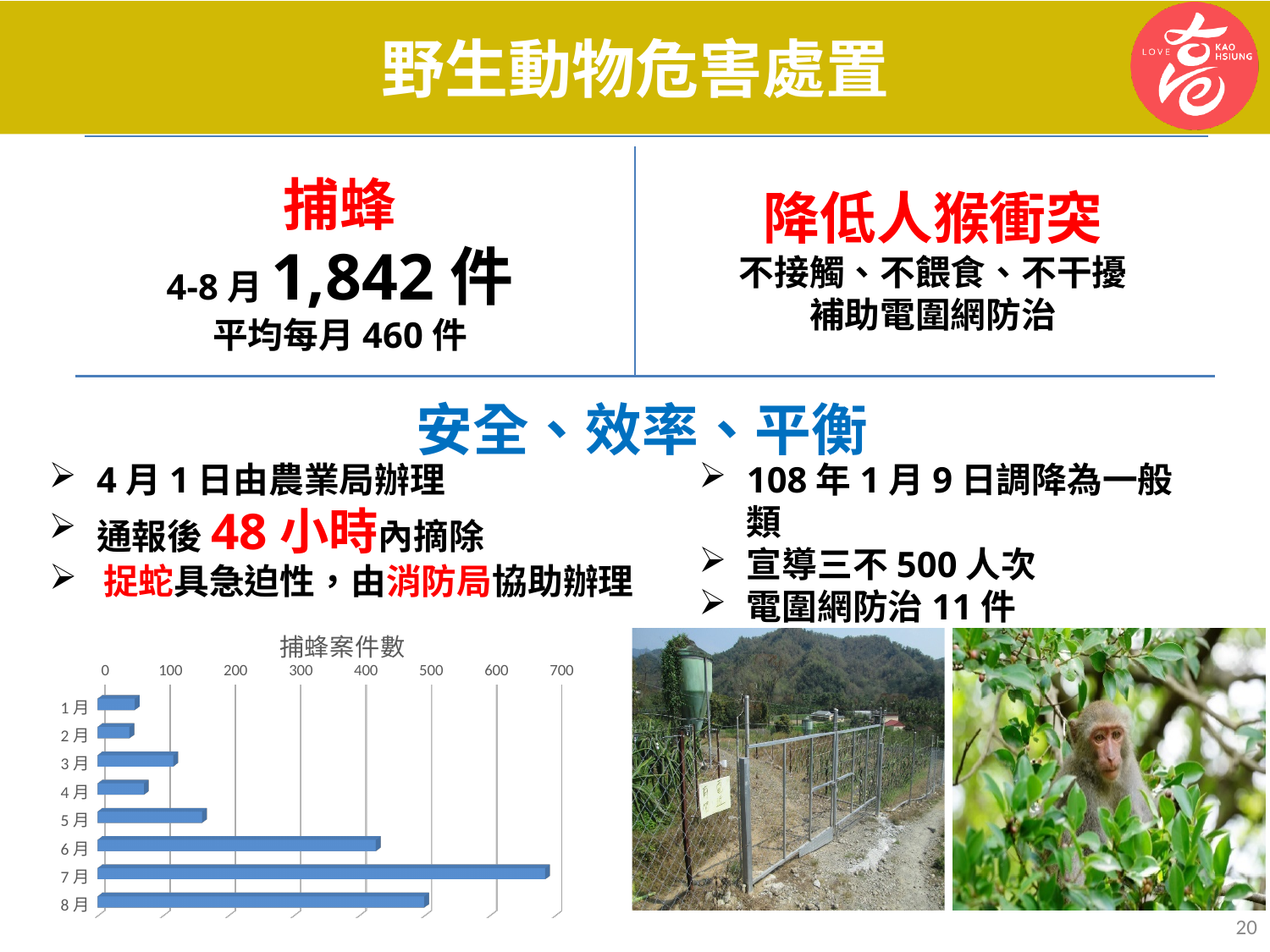
How many months are shown in the 捕蜂案件數 chart? 8 In the 捕蜂案件數 chart, is the value for 8月 greater or less than 600? less What kind of chart is the 捕蜂案件數 chart? bar chart In the 捕蜂案件數 chart, is the value for 7月 greater or less than 600? greater In the 捕蜂案件數 chart, is the value for 5月 greater or less than 200? less In the 捕蜂案件數 chart, which is larger, the value for 3月 or the value for 4月? 3月 What is the title of the chart at the bottom left of the slide? 捕蜂案件數 In the 捕蜂案件數 chart, do the values rise or fall from 4月 to 7月? rise Which month has the highest value in the 捕蜂案件數 chart? 7月 In the 捕蜂案件數 chart, which is larger, the value for 7月 or the value for 8月? 7月